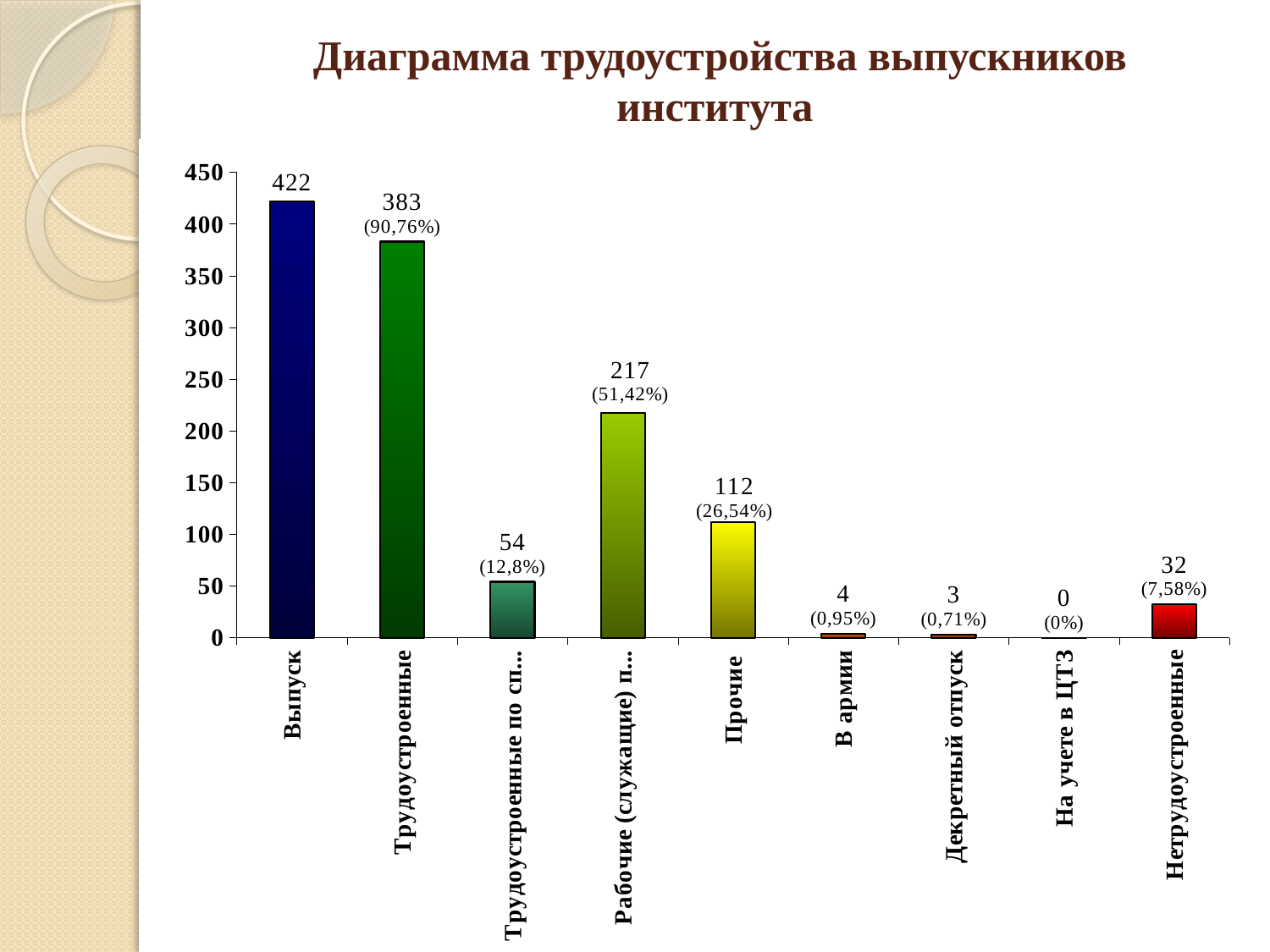
Which category has the lowest value? На учете в ЦТЗ What is the value for Выпуск? 422 What kind of chart is shown on the slide? Bar chart How many categories are shown on the x axis? 9 What is the value for Трудоустроенные? 383 What is the difference between the values for Выпуск and Трудоустроенные? 39 Which is larger, the value for В армии or the value for Нетрудоустроенные? Нетрудоустроенные What is the value for Прочие? 112 Which category has the highest value? Выпуск What is the title of the slide? Диаграмма трудоустройства выпускников института What percentage is shown above the bar for Нетрудоустроенные? 7,58% What is the value for Декретный отпуск? 3